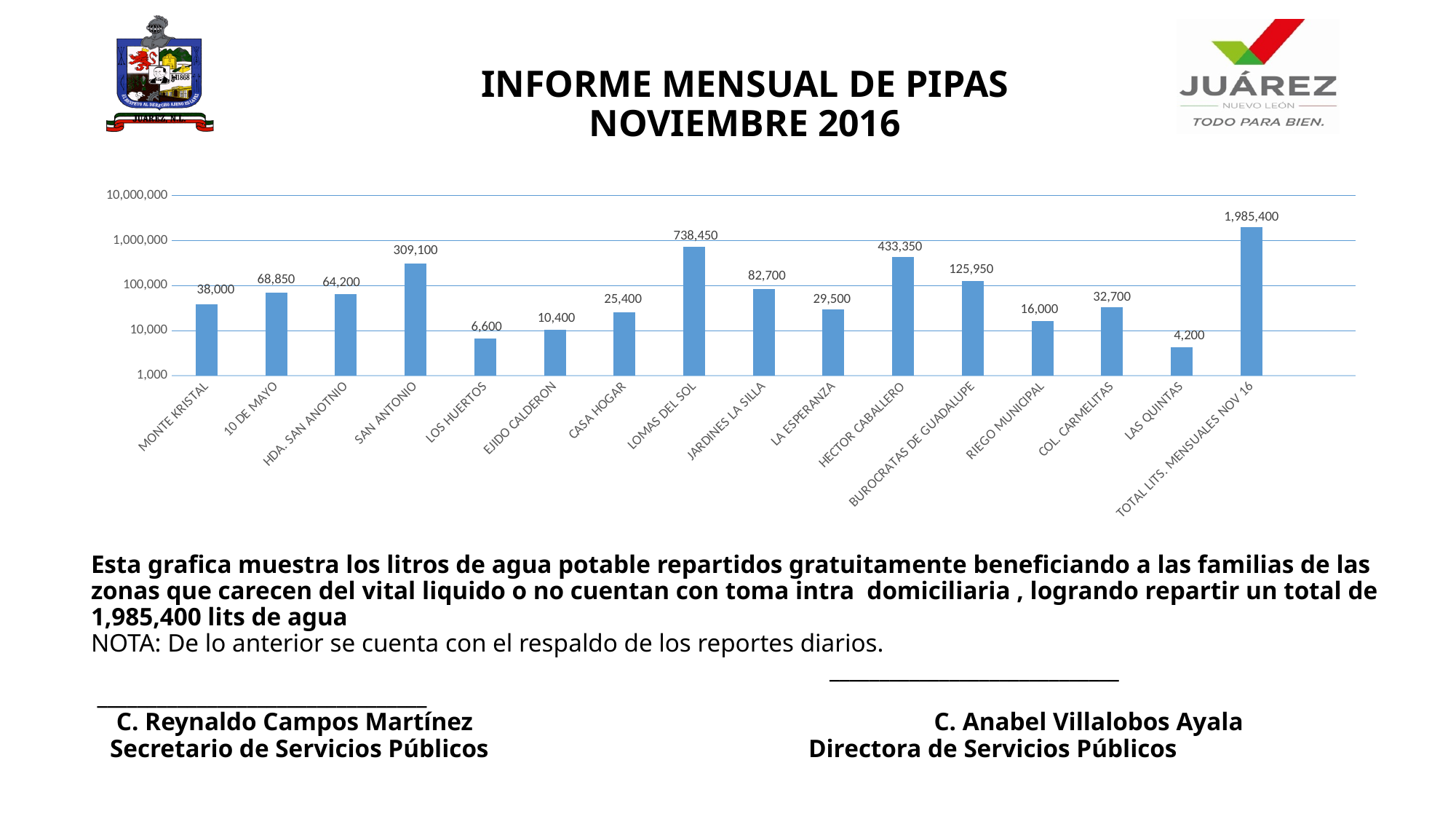
What is the value for LOMAS DEL SOL? 738,450 What is the difference between the values for SAN ANTONIO and HDA. SAN ANOTNIO? 244,900 What kind of chart is shown on the slide? bar chart What is the value for LAS QUINTAS? 4,200 Excluding the total bar, which category has the highest value? LOMAS DEL SOL What is the highest tick value shown on the vertical axis? 10,000,000 Which category has the lowest value? LAS QUINTAS What is the value shown for TOTAL LITS. MENSUALES NOV 16? 1,985,400 What is the value for HECTOR CABALLERO? 433,350 Which is larger, the value for 10 DE MAYO or the value for JARDINES LA SILLA? JARDINES LA SILLA Is the value for BUROCRATAS DE GUADALUPE greater or less than 100,000? greater How many bars are plotted in the chart? 16